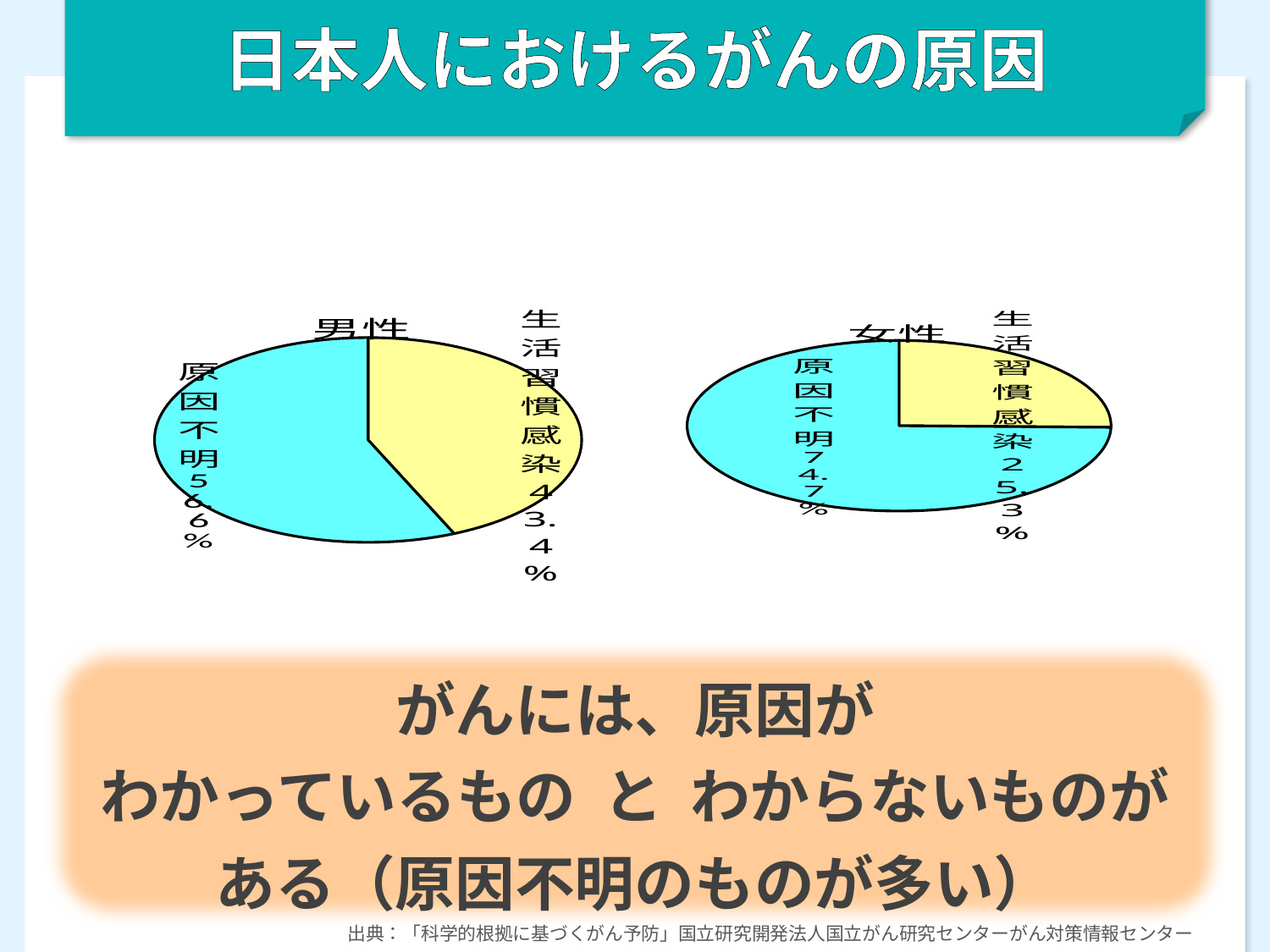
Which chart shows a larger share for 生活習慣感染, the 男性 chart or the 女性 chart? 男性 What kind of chart is used for the 男性 chart? pie chart What colour is the 原因不明 slice in the 男性 chart? cyan In the 男性 chart, what percentage is shown for 原因不明? 56.6% In the 女性 chart, what percentage is shown for 生活習慣感染? 25.3% In the 男性 chart, what percentage is shown for 生活習慣感染? 43.4% How many slices does the 女性 pie chart have? 2 In the 男性 chart, what is the difference between the 原因不明 and 生活習慣感染 percentages? 13.2% In the 女性 chart, what is the difference between the 原因不明 and 生活習慣感染 percentages? 49.4% In the 女性 chart, what percentage is shown for 原因不明? 74.7% In the 女性 chart, which slice is the largest? 原因不明 In the 男性 chart, which slice is the smallest? 生活習慣感染